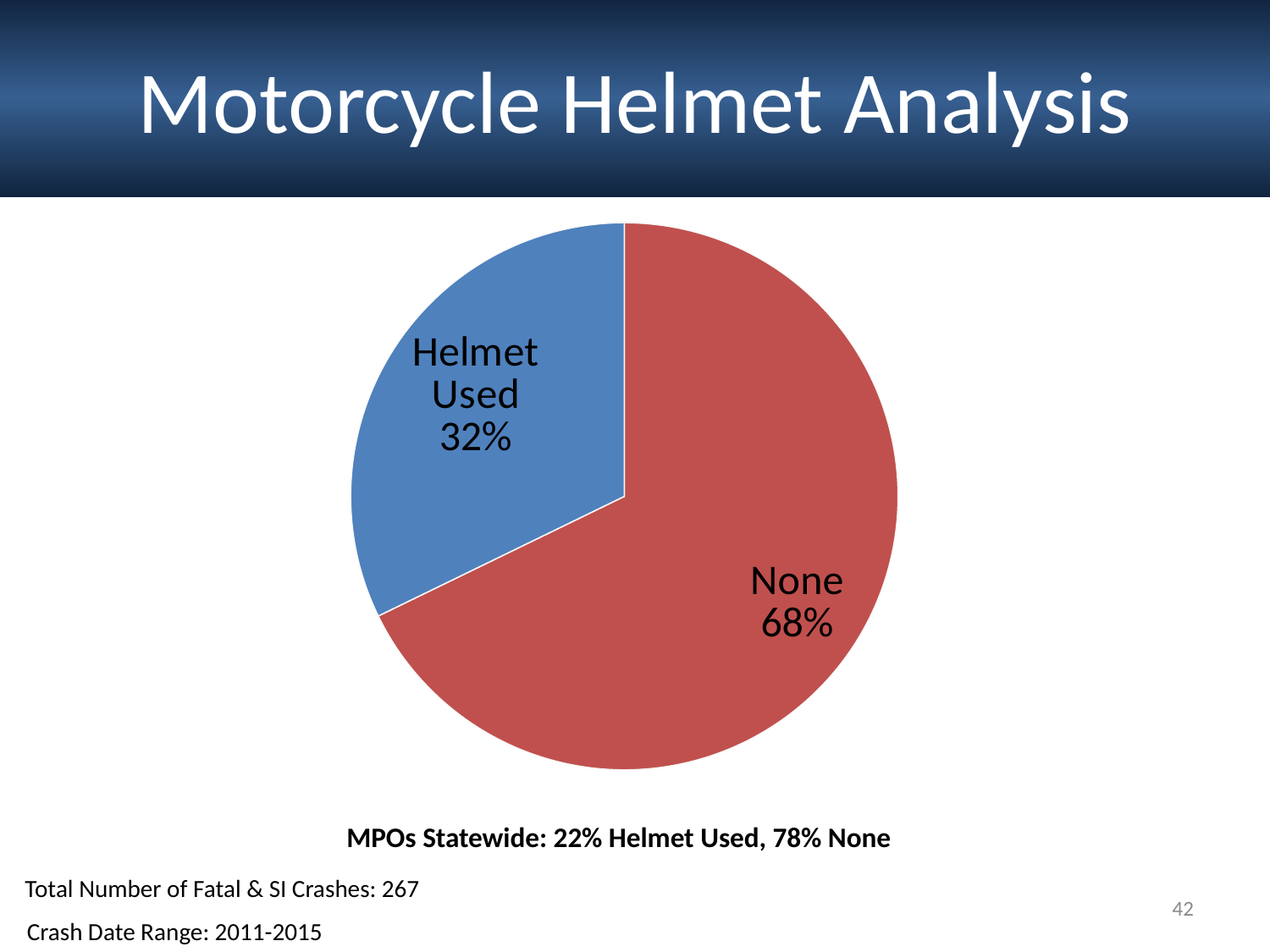
What colour is the "None" slice of the pie? red What share of the pie is labelled "None"? 68% What is the difference in percentage points between the "None" slice and the "Helmet Used" slice? 36 Is the share for "Helmet Used" greater or less than 50%? less Which slice of the pie is the smallest? Helmet Used What colour is the "Helmet Used" slice of the pie? blue Which slice of the pie is the largest? None What kind of chart is shown on the slide? pie chart How many slices does the pie chart have? 2 Which is larger, the "Helmet Used" slice or the "None" slice? None What share of the pie is labelled "Helmet Used"? 32%